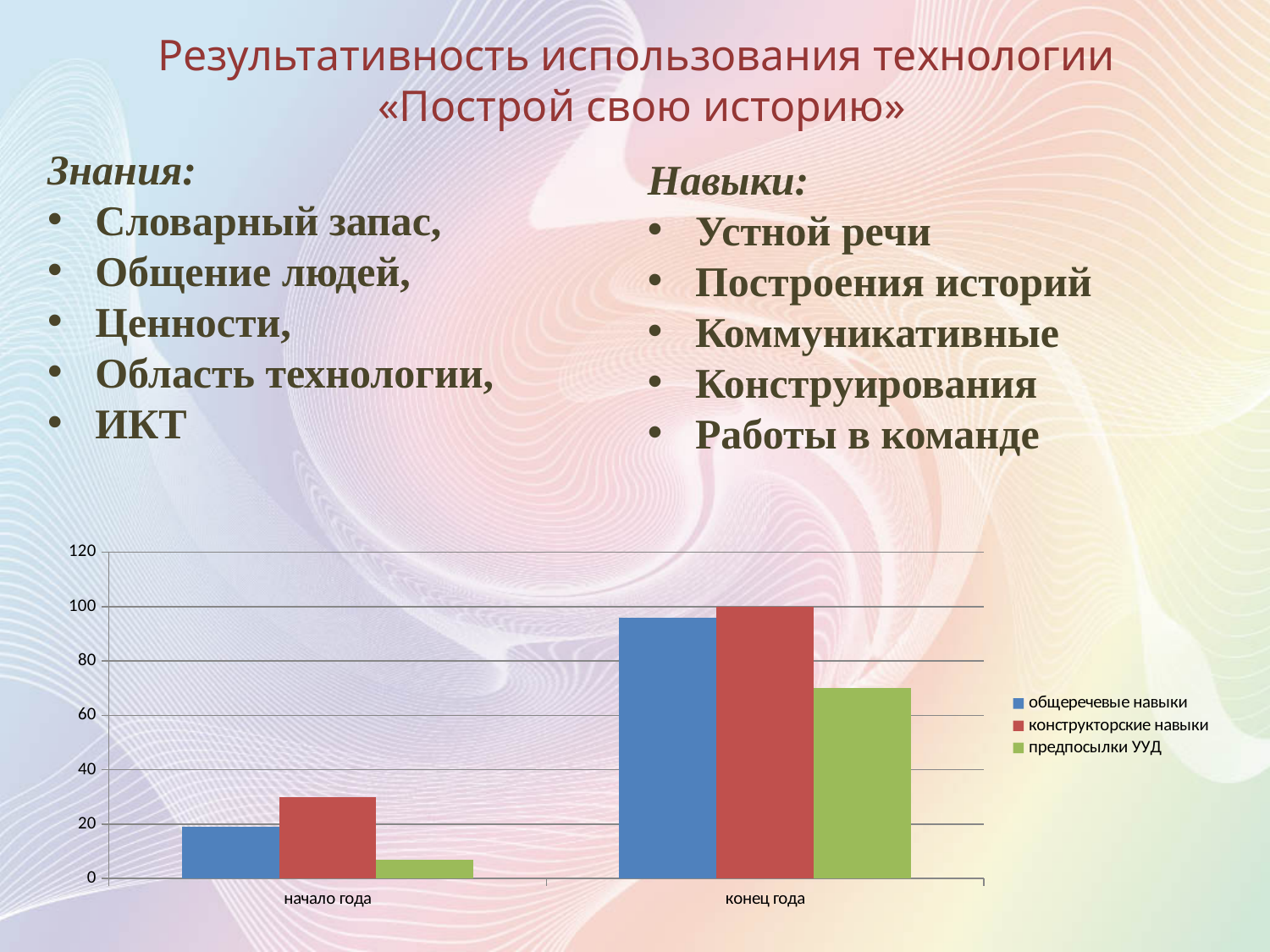
Which series has the lowest value for начало года? предпосылки УУД Is the value of предпосылки УУД for начало года greater or less than 20? less Which series has the lowest value for конец года? предпосылки УУД Which series has the highest value for начало года? конструкторские навыки Is the value of предпосылки УУД for конец года greater or less than 60? greater Do the values of общеречевые навыки rise or fall from начало года to конец года? rise How many series does the chart legend list? 3 How many categories are shown on the x axis of the chart? 2 Is the value of конструкторские навыки for начало года greater or less than 40? less Which is larger: предпосылки УУД for конец года or конструкторские навыки for начало года? предпосылки УУД for конец года What kind of chart is shown at the bottom of the slide? bar chart